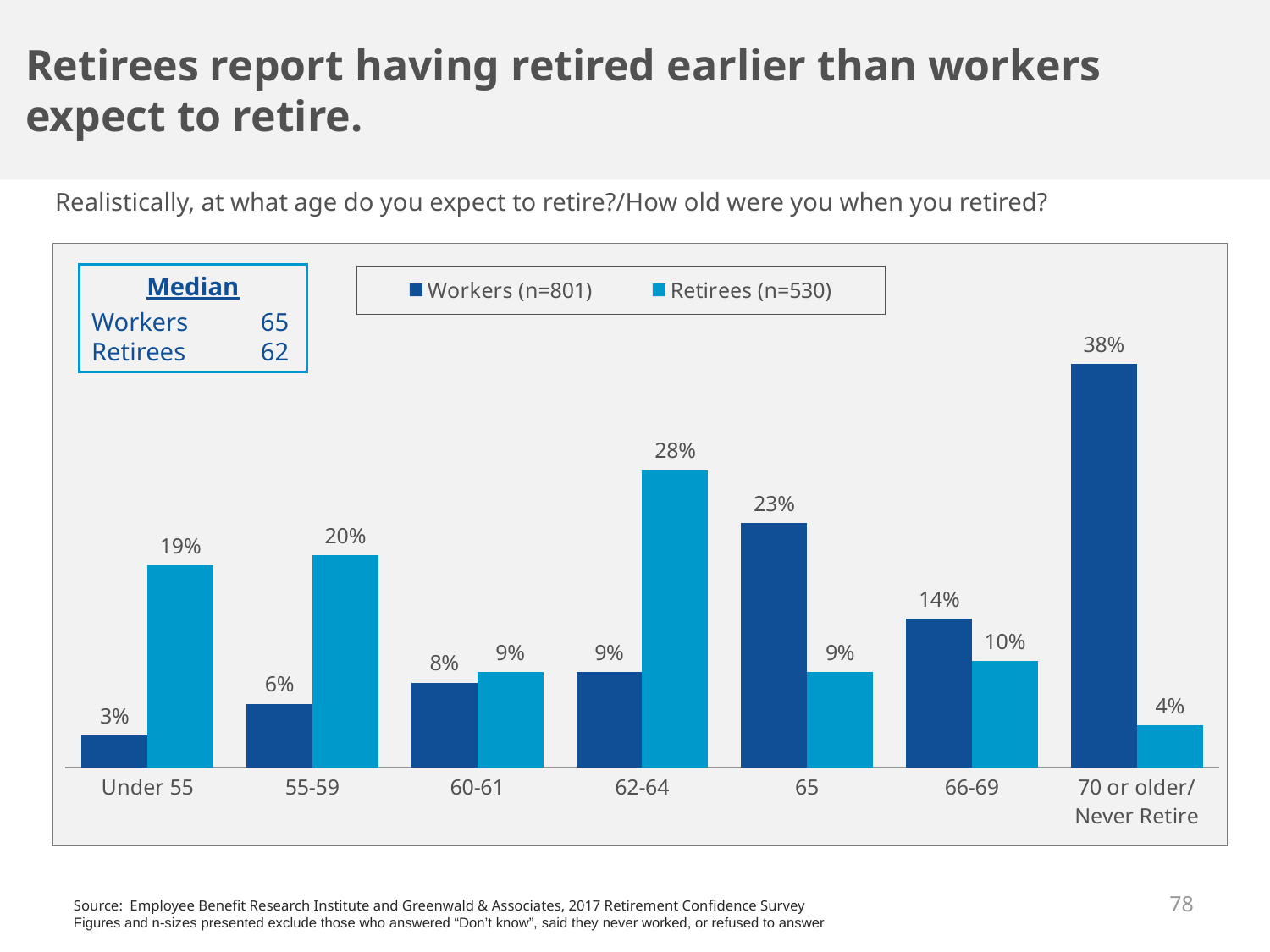
How many age categories are shown on the x axis? 7 What is the difference between the Workers and Retirees values for the 55-59 category? 14% What percentage of Workers expect to retire at 70 or older/Never Retire? 38% What percentage of Retirees retired at age 62-64? 28% Which age category has the highest value for Workers? 70 or older/ Never Retire For the 66-69 category, which series has the larger value, Workers or Retirees? Workers According to the Median box on the chart, what is the median retirement age for Retirees? 62 What kind of chart is shown on the slide? Bar chart Which age category has the lowest value for Retirees? 70 or older/ Never Retire How many series does the legend list? 2 What percentage of Retirees retired Under 55? 19% What percentage of Workers expect to retire at 65? 23%